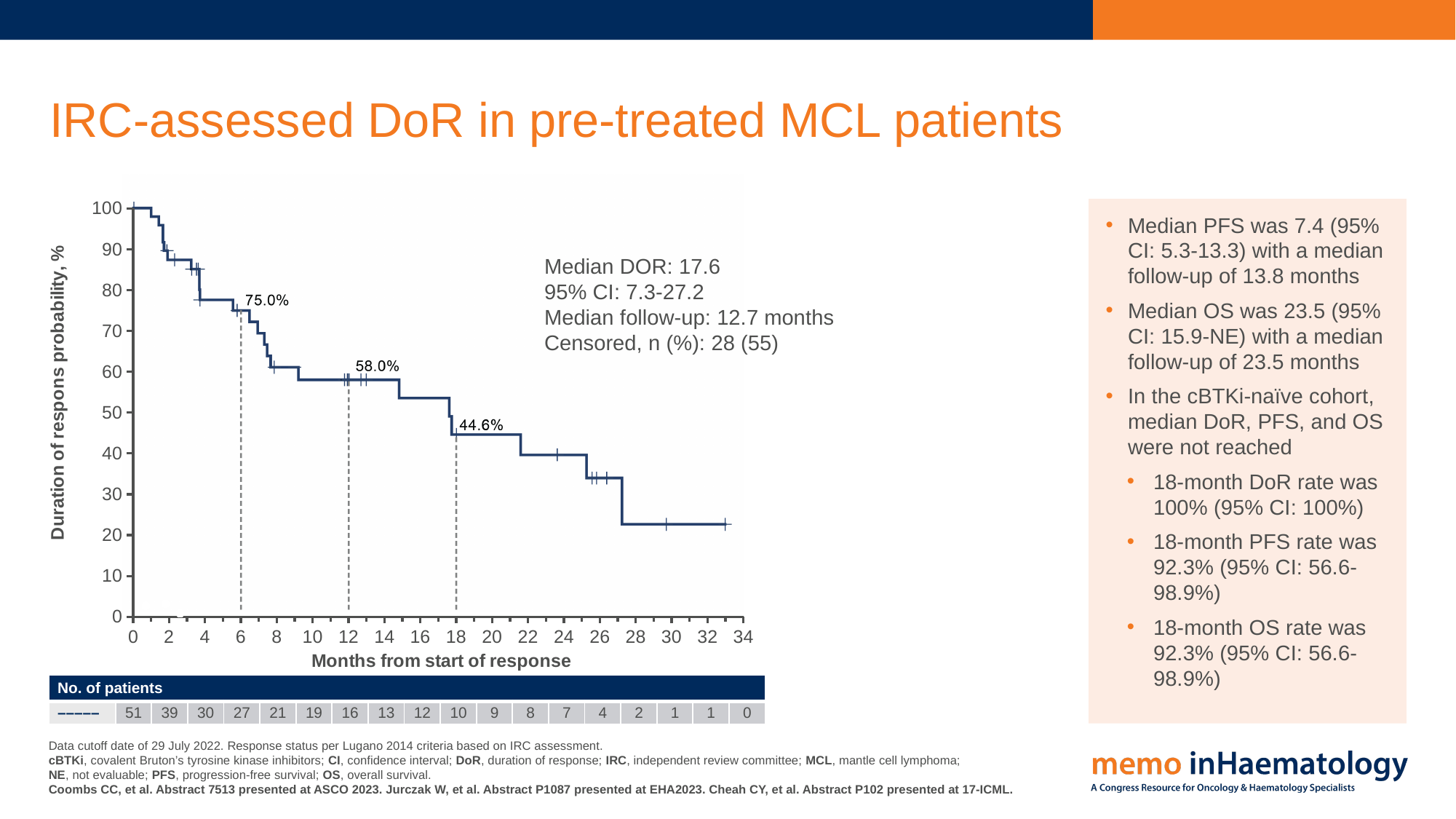
What is the duration of response probability at 12 months, as labelled on the curve? 58.0% By how many percentage points does the labelled response probability drop between 6 months and 12 months? 17.0 percentage points How many patients are at risk at 0 months according to the 'No. of patients' row? 51 How many patients are at risk at 12 months according to the 'No. of patients' row? 16 What kind of chart is shown on the slide? A Kaplan-Meier step line chart Does the duration of response probability rise or fall as months from start of response increase? Fall By how many percentage points does the labelled response probability drop between 12 months and 18 months? 13.4 percentage points What is the title of the x axis of the chart? Months from start of response What is the duration of response probability at 6 months, as labelled on the curve? 75.0% How many patients are at risk at 24 months according to the 'No. of patients' row? 7 What is the duration of response probability at 18 months, as labelled on the curve? 44.6% Is the duration of response probability at 30 months greater or less than 30? less